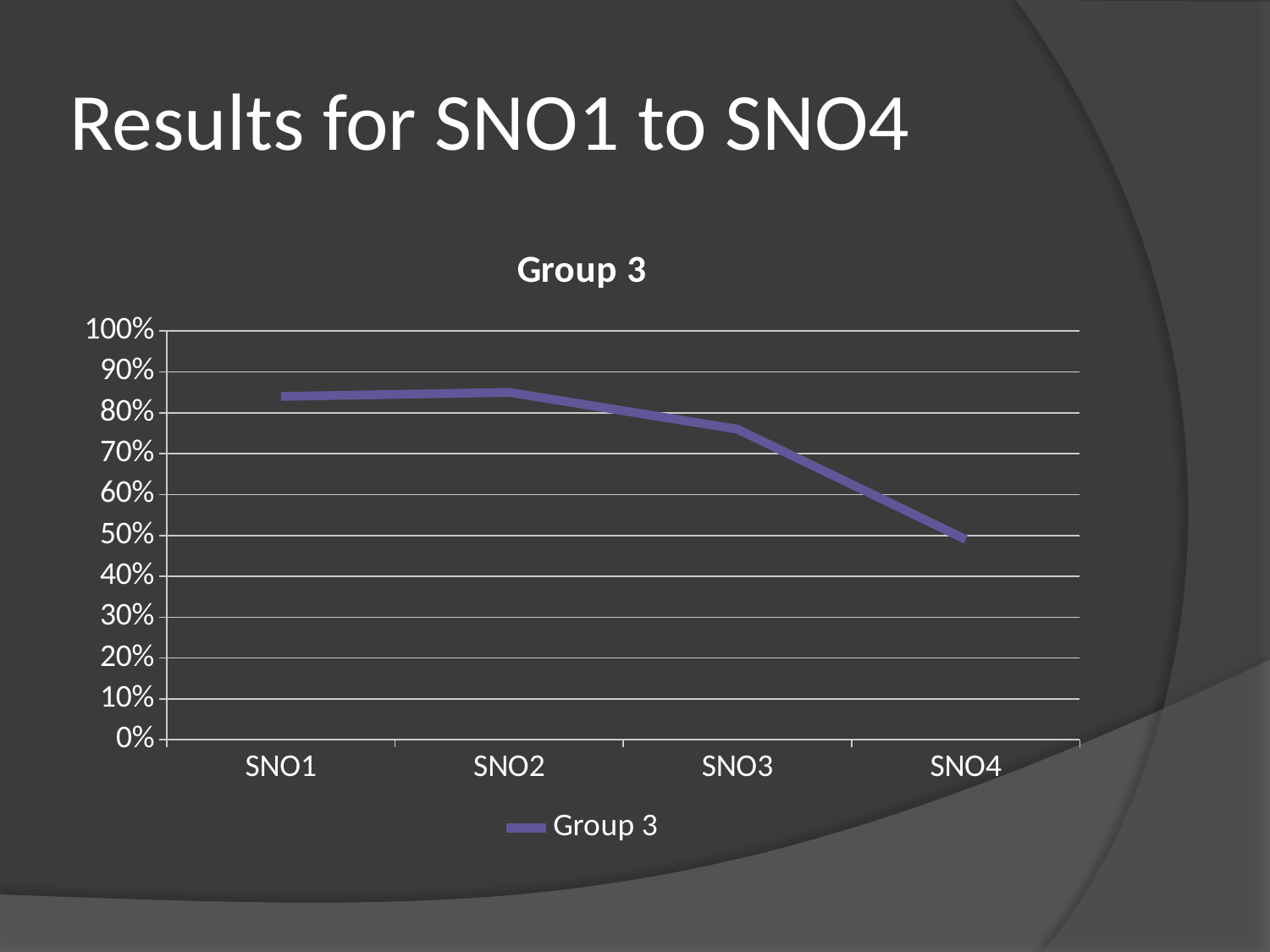
Which is larger, the value for SNO3 or the value for SNO4? SNO3 What kind of chart is shown on the slide? line chart Is the value for SNO2 greater or less than 90%? less How many series does the legend list? 1 Which category has the lowest value? SNO4 Which is larger, the value for SNO1 or the value for SNO3? SNO1 What is the title of the chart? Group 3 Do the values generally rise or fall from SNO1 to SNO4? fall Is the value for SNO1 greater or less than 80%? greater Is the value for SNO4 greater or less than 60%? less How many categories are shown on the x axis? 4